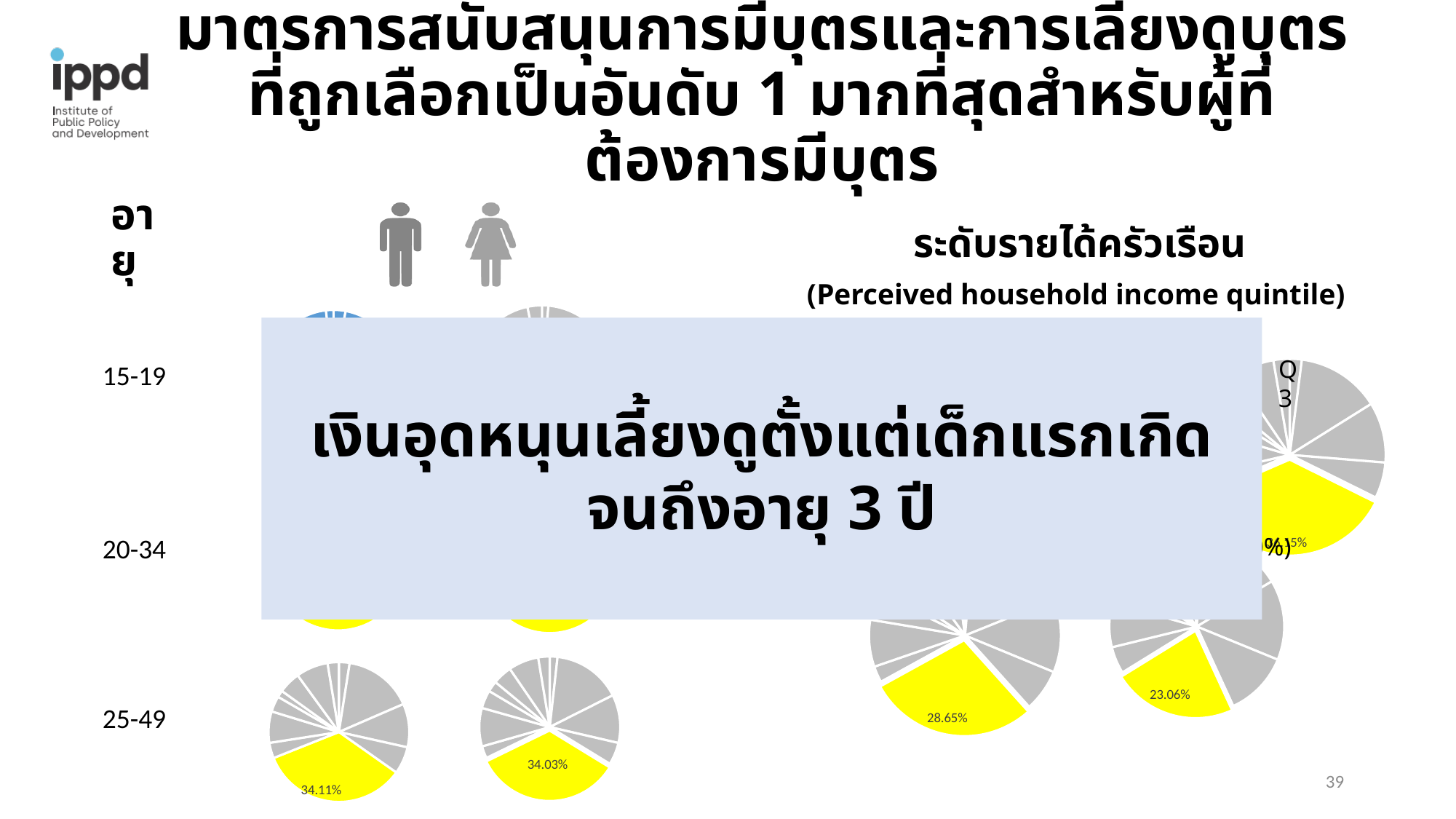
What kind of chart is used on this slide to show the share of respondents choosing each measure? pie chart In the pie chart at the bottom right corner of the slide, what percentage is printed on the yellow slice? 23.06% What colour is used to highlight the top-ranked measure in each pie chart? yellow In the pie chart for women aged 25-49 (second from left in the bottom row), what percentage is printed on the yellow slice? 34.03% Which is larger, the yellow slice for men aged 25-49 (34.11%) or the yellow slice for women aged 25-49 (34.03%)? men aged 25-49 (34.11%) Among the four pie charts with readable yellow-slice labels (34.11%, 34.03%, 28.65%, 23.06%), which has the largest yellow slice? men aged 25-49 (34.11%) What is the difference between the yellow slice labelled 28.65% and the yellow slice labelled 23.06% in the two bottom-right pie charts? 5.59 percentage points Among the four pie charts with readable yellow-slice labels (34.11%, 34.03%, 28.65%, 23.06%), which has the smallest yellow slice? the bottom-right pie chart (23.06%) In the pie chart immediately to the left of the bottom-right pie chart, what percentage is printed on the yellow slice? 28.65% What is the difference between the yellow slice for men aged 25-49 (34.11%) and for women aged 25-49 (34.03%)? 0.08 percentage points In the pie chart for men aged 25-49 (bottom left), what percentage is printed on the yellow slice? 34.11% How many age groups are listed down the left side of the slide? 3